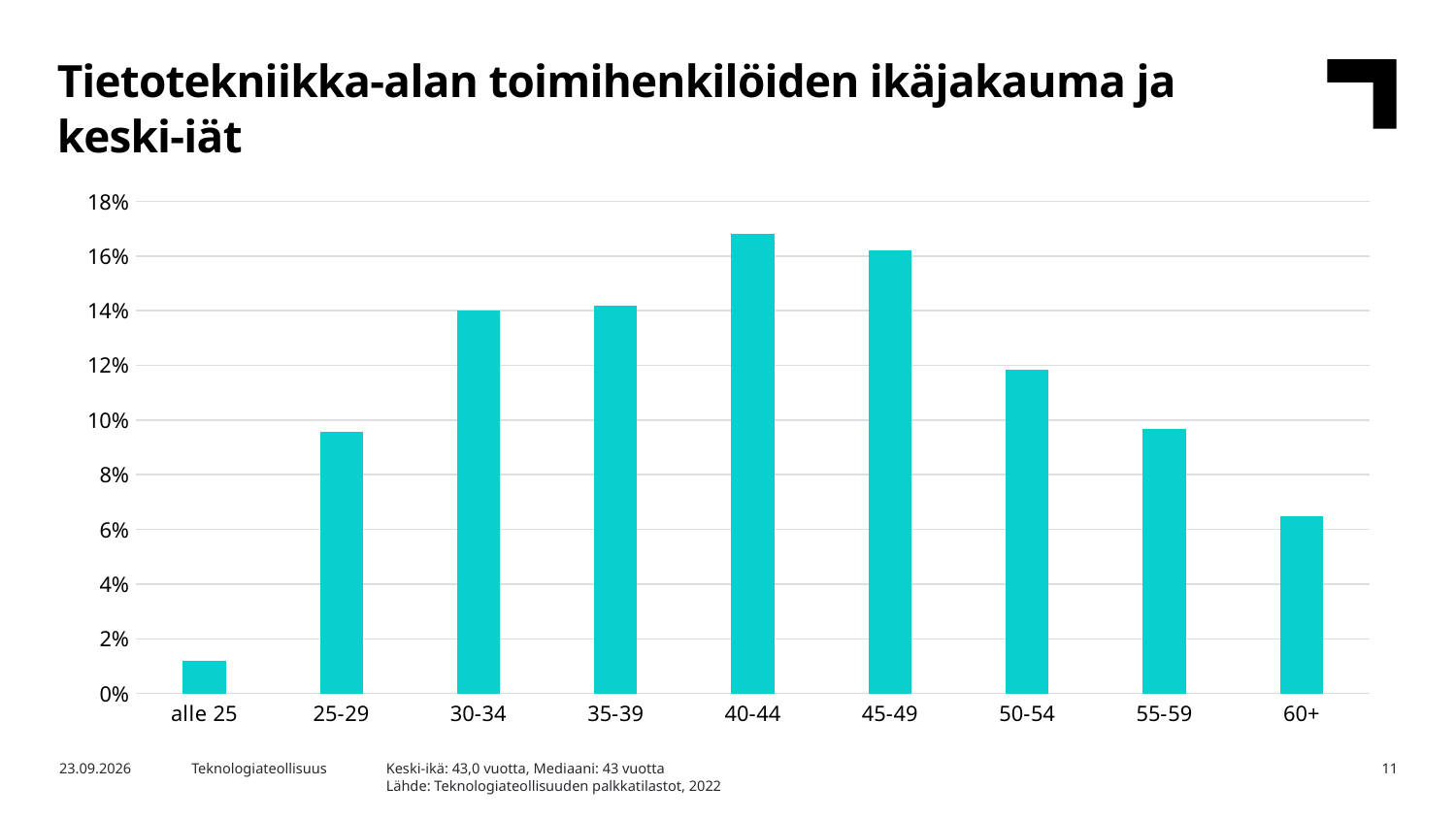
Is the value for 40-44 greater or less than 16%? greater What kind of chart is shown on the slide? Bar chart Is the value for 60+ greater or less than 6%? greater How many age categories are shown on the x axis? 9 Which is larger, the value for 50-54 or the value for 60+? 50-54 Which age category has the lowest share? alle 25 What is the title of the chart on the slide? Tietotekniikka-alan toimihenkilöiden ikäjakauma ja keski-iät Is the value for 25-29 greater or less than 10%? less Which age category has the highest share? 40-44 Do the values rise or fall from 40-44 to 60+ along the x axis? fall